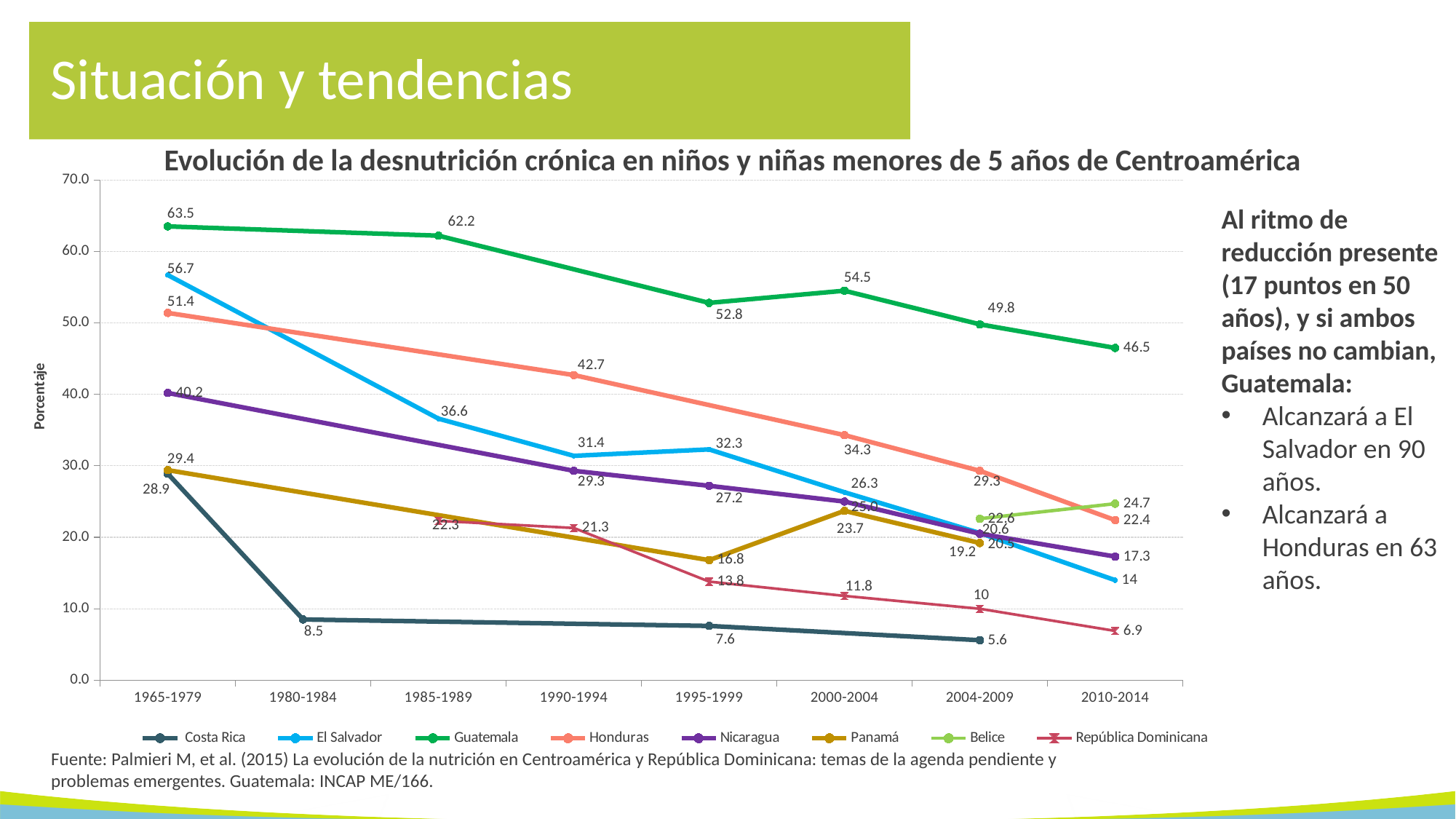
What type of chart is shown on the slide? line chart What is the value for Guatemala in 1965-1979? 63.5 In 2010-2014, which is larger, the value for Honduras or the value for Nicaragua? Honduras What is the value for El Salvador in 2010-2014? 14 What is the value for Costa Rica in 2004-2009? 5.6 What is the value for Guatemala in 2010-2014? 46.5 By how much did Guatemala's value fall from 1965-1979 to 2010-2014? 17.0 Which country has the lowest value in 2010-2014? República Dominicana Which country has the highest value in 2010-2014? Guatemala What is the value for Honduras in 1990-1994? 42.7 How many series does the legend list? 8 Does the value for Guatemala rise or fall from 1965-1979 to 2010-2014? fall